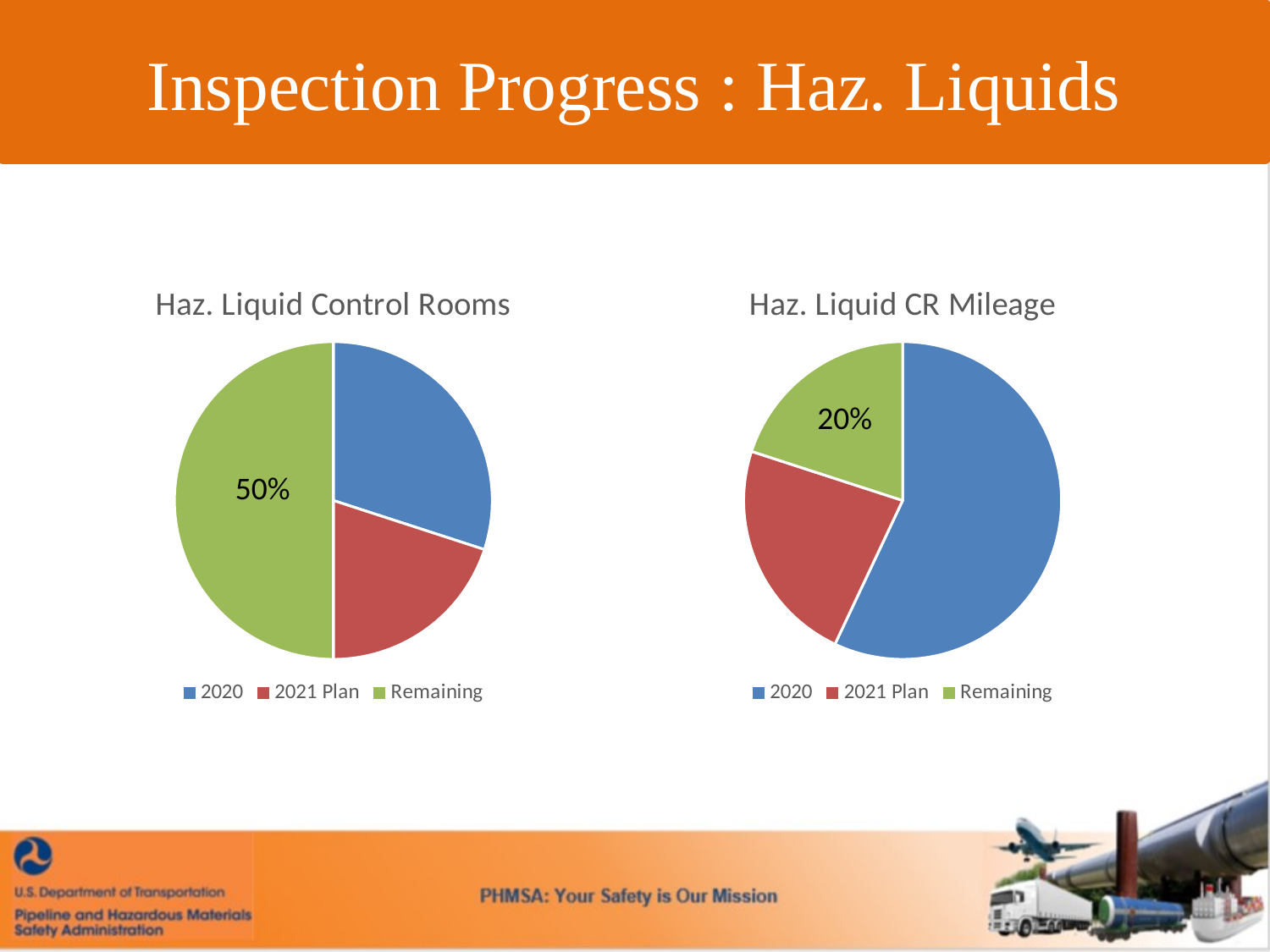
In the Haz. Liquid Control Rooms chart, which slice is larger: 2020 or 2021 Plan? 2020 In the Haz. Liquid Control Rooms chart, what share of the pie is labelled for Remaining? 50% How many slices does the Haz. Liquid Control Rooms pie have? 3 What kind of chart is the Haz. Liquid Control Rooms chart? Pie chart In the Haz. Liquid CR Mileage chart, which slice is larger: 2020 or Remaining? 2020 In the Haz. Liquid CR Mileage chart, which category has the largest slice? 2020 What colour represents Remaining in the legend of the Haz. Liquid CR Mileage chart? Green In the Haz. Liquid Control Rooms chart, which category has the largest slice? Remaining How many entries does the legend of the Haz. Liquid CR Mileage chart list? 3 In the Haz. Liquid CR Mileage chart, what share of the pie is labelled for Remaining? 20% By how many percentage points does the Remaining share in the Haz. Liquid Control Rooms chart exceed the Remaining share in the Haz. Liquid CR Mileage chart? 30 percentage points In the Haz. Liquid Control Rooms chart, which category has the smallest slice? 2021 Plan